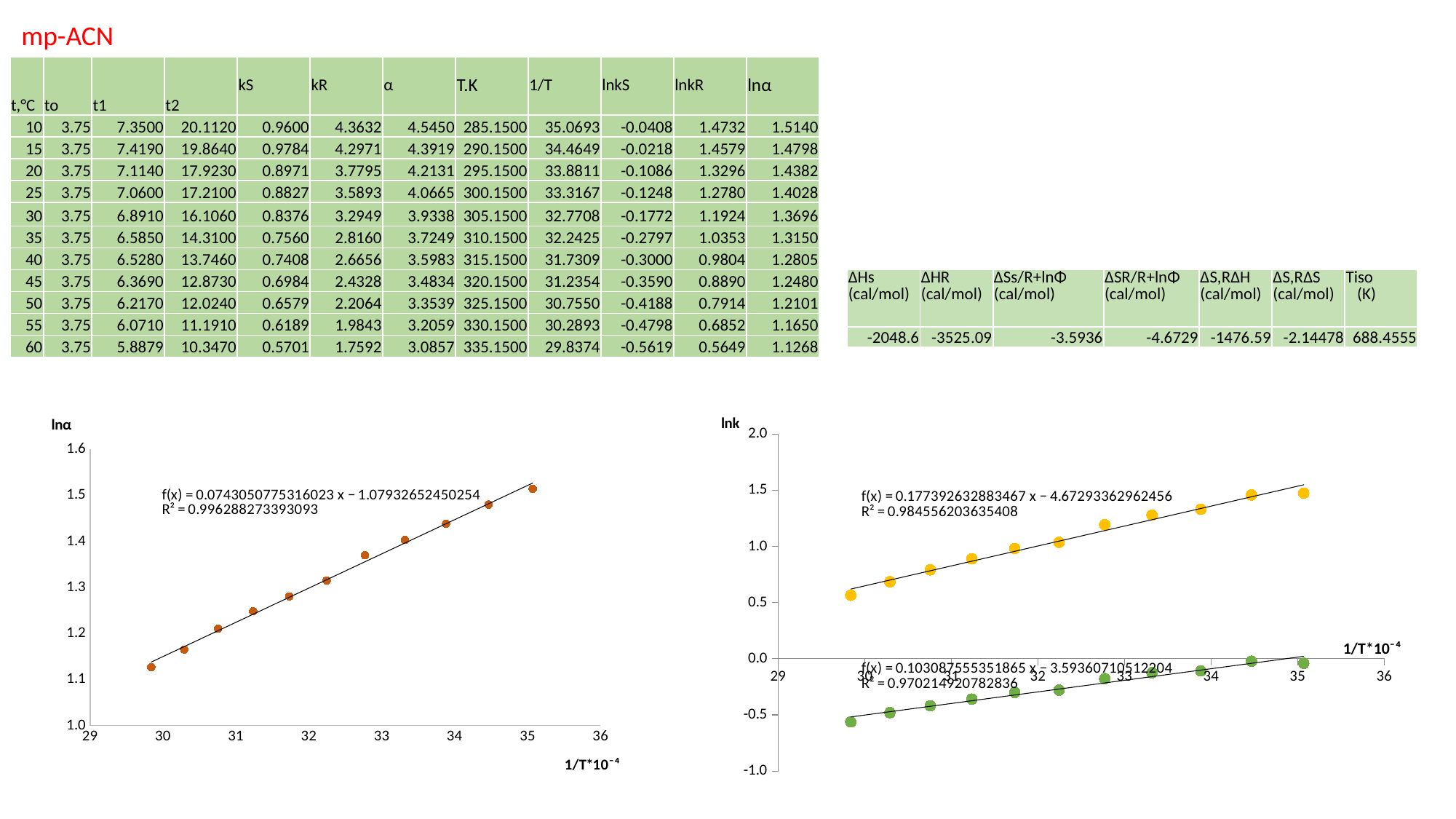
In the right chart (lnk), is the value of the green point near 1/T*10⁻⁴ = 33.3 greater or less than -0.5? greater In the left chart (lnα), is the value of the leftmost point (near 1/T*10⁻⁴ = 30) greater or less than 1.1? greater In the right chart (lnk), how many yellow data points are plotted? 11 In the left chart (lnα), is the value of the point near 1/T*10⁻⁴ = 34 greater or less than 1.4? greater In the right chart (lnk), do the green points rise or fall as 1/T*10⁻⁴ increases? rise What kind of chart is the left chart titled lnα? scatter chart In the left chart (lnα), what R² value is shown for the trendline? 0.996288273393093 In the left chart (lnα), how many data points are plotted? 11 In the left chart (lnα), do the values rise or fall as 1/T*10⁻⁴ increases? rise In the right chart (lnk), what R² value is shown for the trendline of the yellow series? 0.984556203635408 In the right chart (lnk), which series has the higher values, the yellow points or the green points? yellow